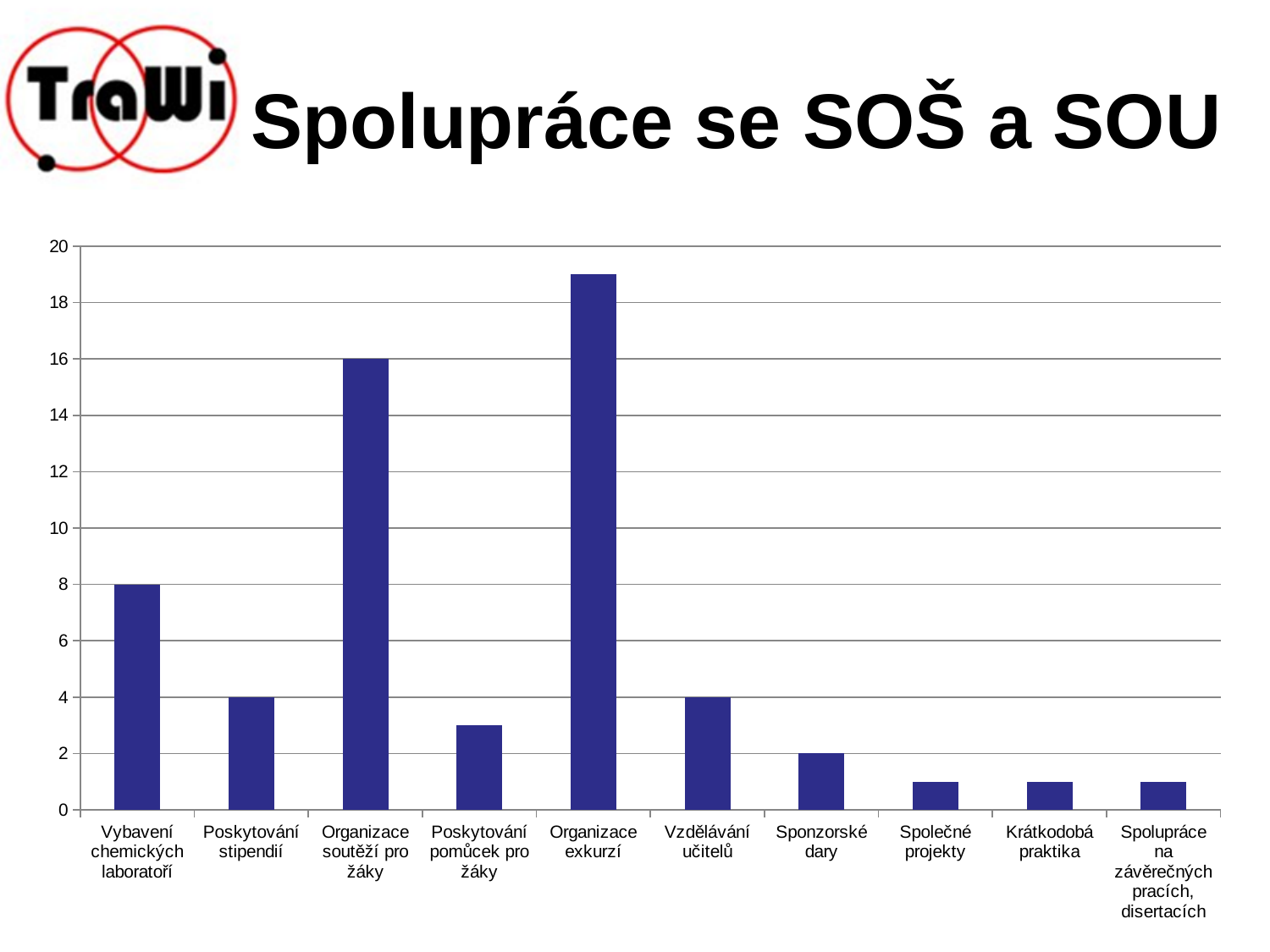
Is the value for Poskytování pomůcek pro žáky greater or less than 4? less What is the value for Organizace soutěží pro žáky? 16 How many categories are shown on the x axis? 10 Which category has the highest value? Organizace exkurzí What is the value for Poskytování stipendií? 4 Which is larger, the value for Vzdělávání učitelů or the value for Sponzorské dary? Vzdělávání učitelů What is the difference between the values for Organizace soutěží pro žáky and Vybavení chemických laboratoří? 8 What is the title of the slide? Spolupráce se SOŠ a SOU What is the value for Vybavení chemických laboratoří? 8 What kind of chart is shown on the slide? Bar chart Is the value for Organizace exkurzí greater or less than 18? greater What is the value for Sponzorské dary? 2